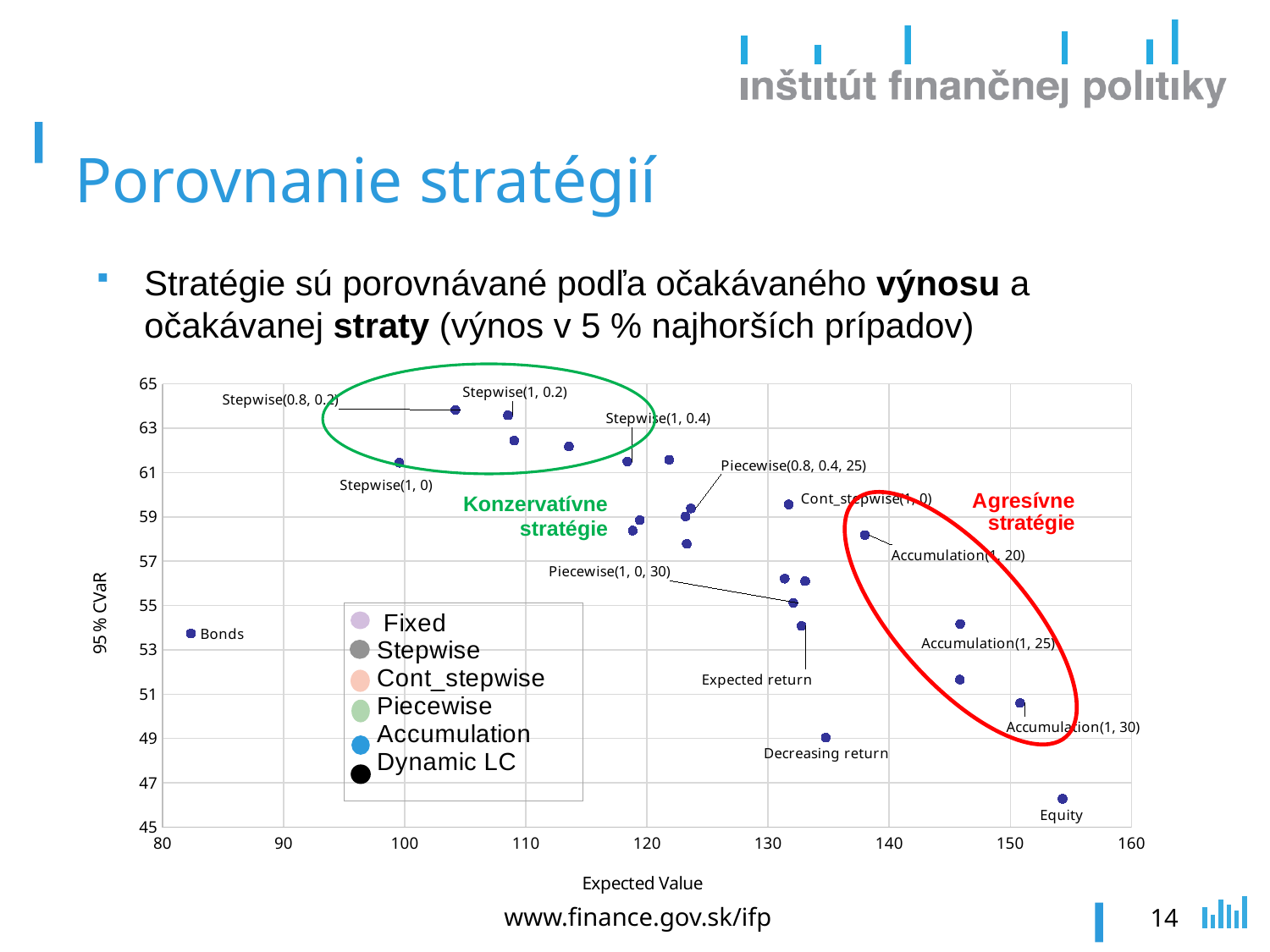
Is the Expected Value for Bonds greater or less than 90? less What kind of chart is shown on the slide? scatter chart What is the title of the y axis of the chart? 95 % CVaR How many entries does the chart legend list? 6 Which has the higher 95 % CVaR, Bonds or Equity? Bonds Is the 95 % CVaR for Equity greater or less than 50? less What is the title of the x axis of the chart? Expected Value Which has the higher Expected Value, Accumulation(1, 30) or Stepwise(1, 0.2)? Accumulation(1, 30) Which labelled point has the highest Expected Value? Equity Is the 95 % CVaR for Stepwise(1, 0) greater or less than 60? greater Which labelled point has the lowest 95 % CVaR? Equity Which labelled point has the lowest Expected Value? Bonds